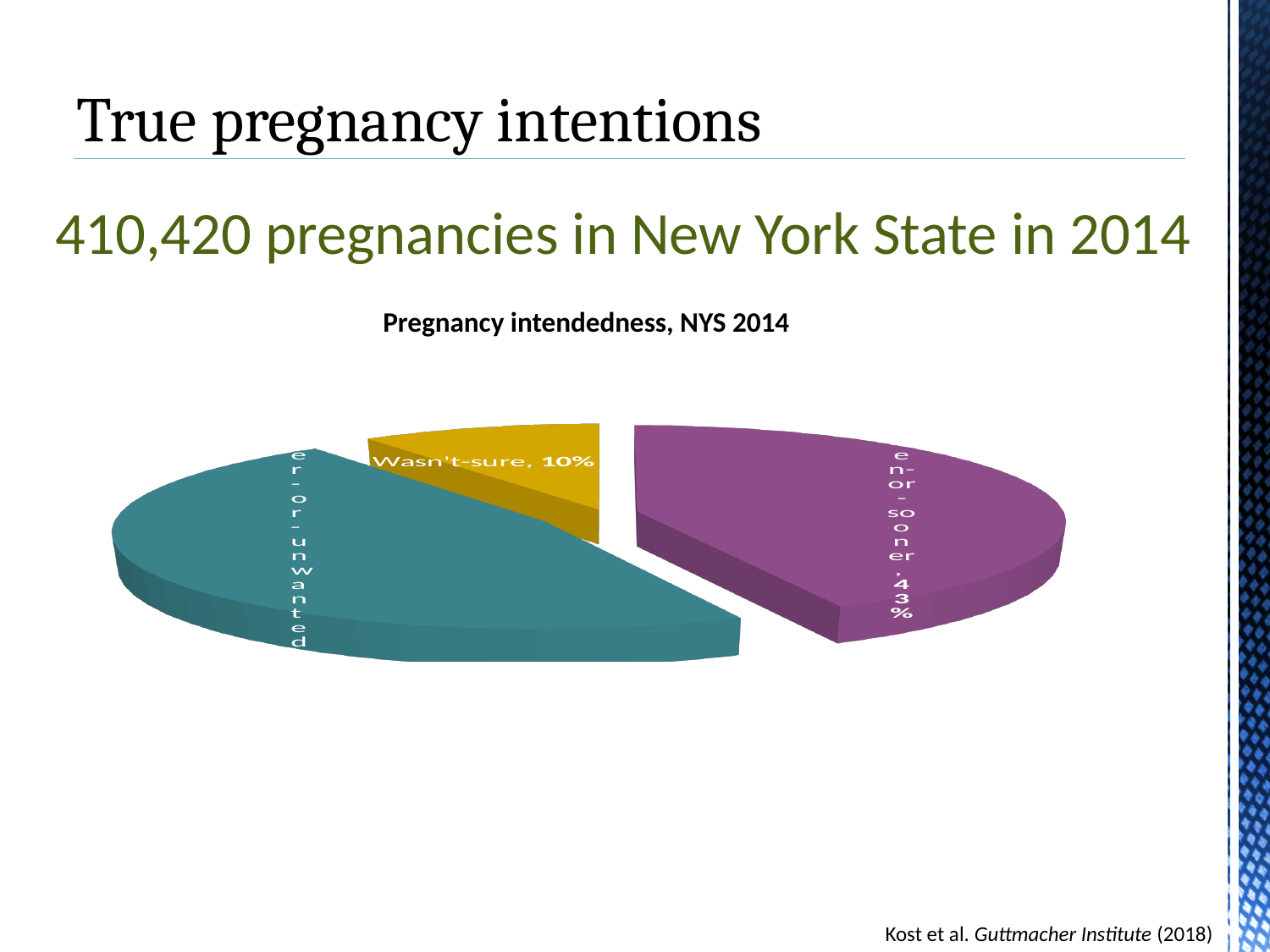
What percentage is labelled on the purple slice of the pie chart? 43% What colour is the 'Wasn't-sure' slice? Yellow Which is larger, the purple slice or the 'Wasn't-sure' slice? The purple slice What kind of chart is shown on the slide? Pie chart What is the difference in percentage points between the purple slice (43%) and the 'Wasn't-sure' slice (10%)? 33 Which is larger, the teal slice or the 'Wasn't-sure' slice? The teal slice How many slices does the pie chart have? 3 Which slice of the pie chart is the smallest? Wasn't-sure What is the title of the chart? Pregnancy intendedness, NYS 2014 What share of the pie does the 'Wasn't-sure' slice represent? 10%